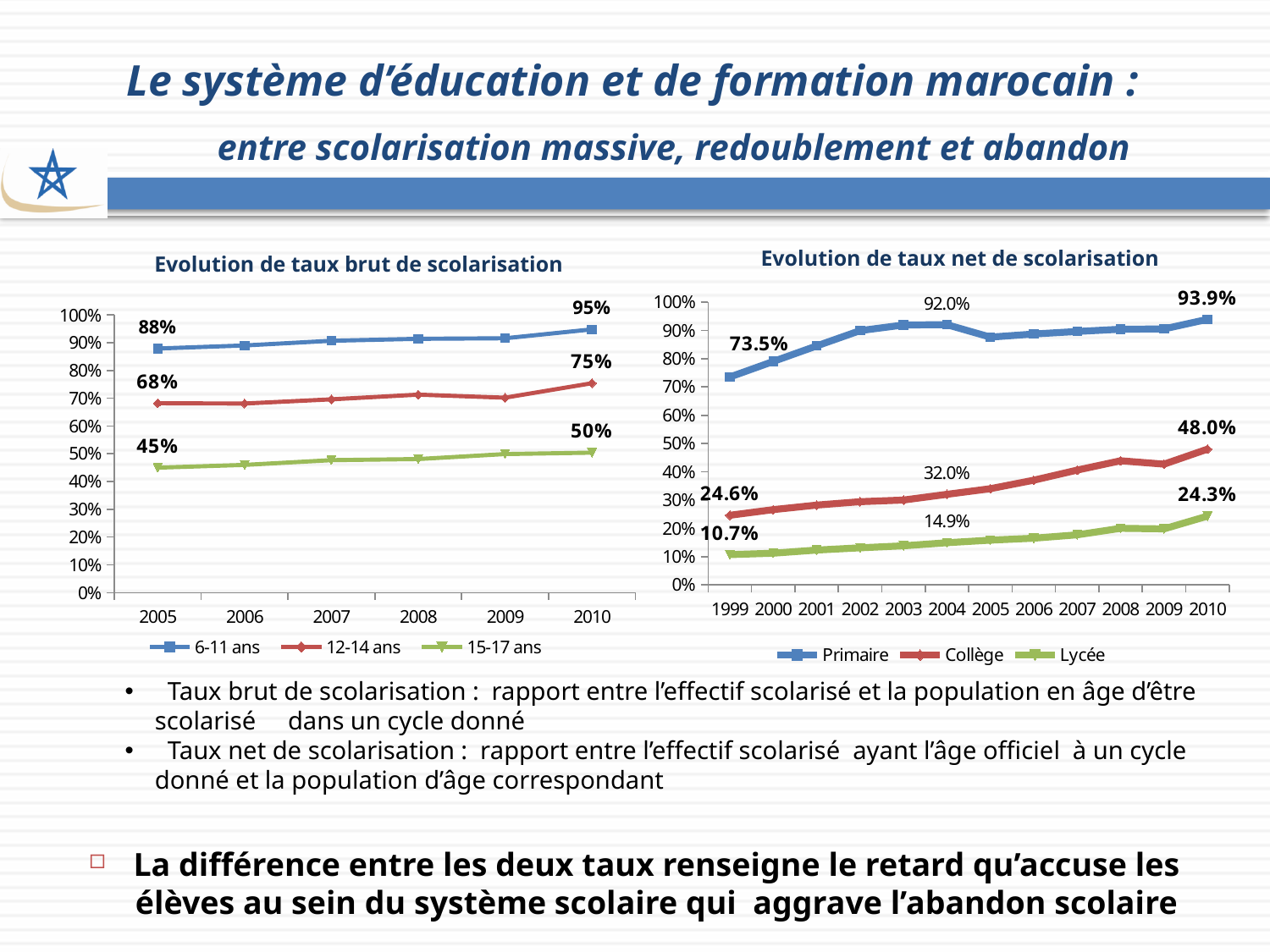
In the chart 'Evolution de taux brut de scolarisation', how many series does the legend list? 3 In the chart 'Evolution de taux brut de scolarisation', what is the value for 15-17 ans in 2010? 50% In the chart 'Evolution de taux net de scolarisation', what is the value for Primaire in 1999? 73.5% In the chart 'Evolution de taux net de scolarisation', what is the value for Lycée in 2004? 14.9% In the chart 'Evolution de taux net de scolarisation', what is the value for Collège in 2010? 48.0% In the chart 'Evolution de taux net de scolarisation', how many years are shown on the x axis? 12 In the chart 'Evolution de taux net de scolarisation', which series has the lowest value in 2010? Lycée In the chart 'Evolution de taux net de scolarisation', is the value for Primaire in 2005 greater or less than 80%? greater In the chart 'Evolution de taux brut de scolarisation', does the 15-17 ans series rise or fall from 2005 to 2010? rise What kind of chart is 'Evolution de taux net de scolarisation'? line chart In the chart 'Evolution de taux brut de scolarisation', what is the value for 6-11 ans in 2005? 88% In the chart 'Evolution de taux brut de scolarisation', by how many percentage points did the 12-14 ans series change from 2005 to 2010? 7 percentage points